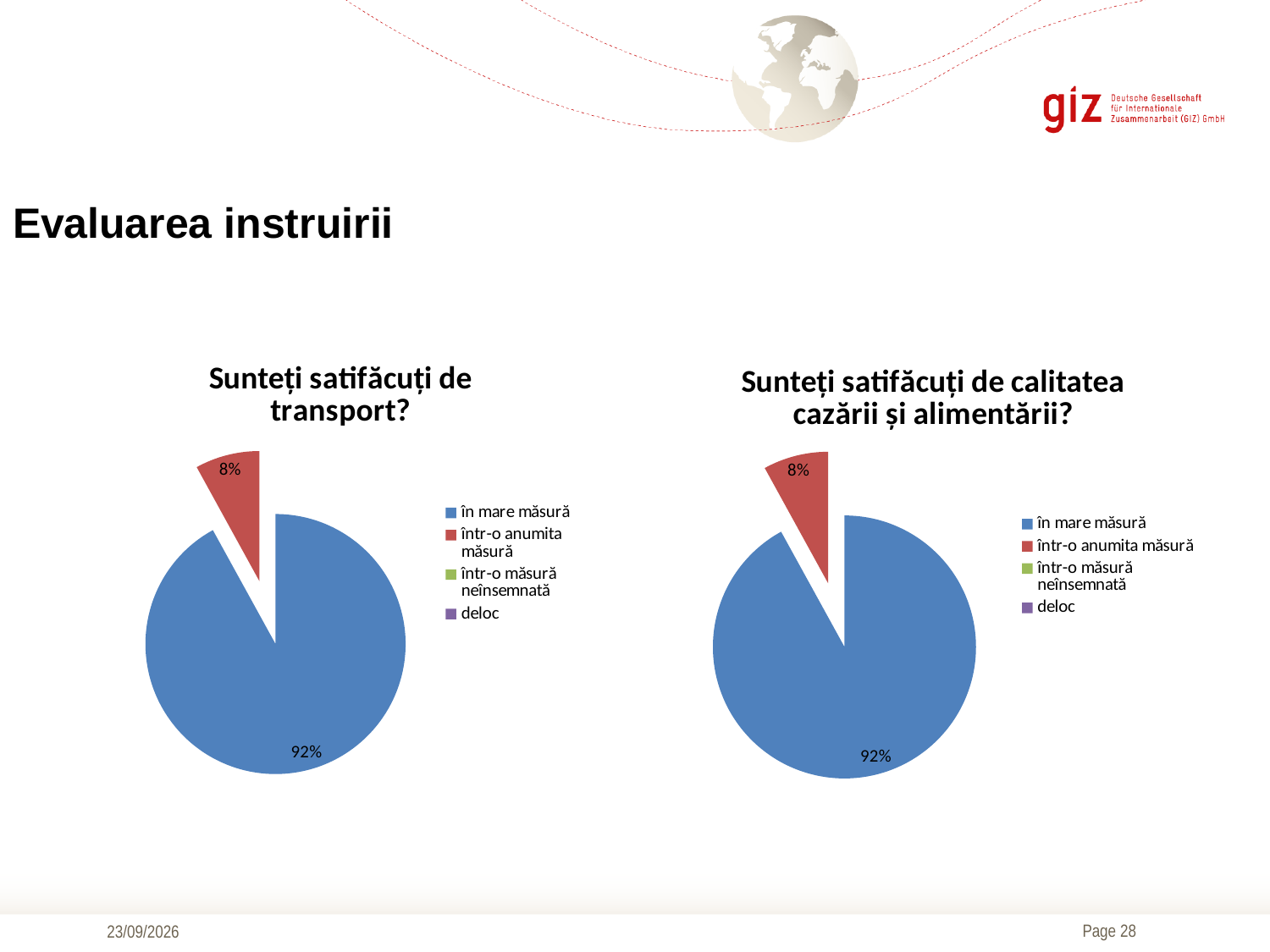
In the right chart titled "Sunteți satifăcuți de calitatea cazării și alimentării?", what share is labelled for "în mare măsură"? 92% In the right chart titled "Sunteți satifăcuți de calitatea cazării și alimentării?", what share is labelled for "într-o anumita măsură"? 8% In the left chart titled "Sunteți satifăcuți de transport?", what is the difference between the shares for "în mare măsură" and "într-o anumita măsură"? 84% In the left chart titled "Sunteți satifăcuți de transport?", which category has the largest slice? în mare măsură In the right chart titled "Sunteți satifăcuți de calitatea cazării și alimentării?", which is larger: the share for "în mare măsură" or for "într-o anumita măsură"? în mare măsură What is the title of the right chart? Sunteți satifăcuți de calitatea cazării și alimentării? How many entries does the legend of the right chart titled "Sunteți satifăcuți de calitatea cazării și alimentării?" list? 4 What type of chart is the left chart titled "Sunteți satifăcuți de transport?"? Pie chart In the left chart titled "Sunteți satifăcuți de transport?", what share is labelled for "în mare măsură"? 92% In the left chart titled "Sunteți satifăcuți de transport?", what colour is the slice for "în mare măsură"? Blue In the right chart titled "Sunteți satifăcuți de calitatea cazării și alimentării?", which category has the largest slice? în mare măsură